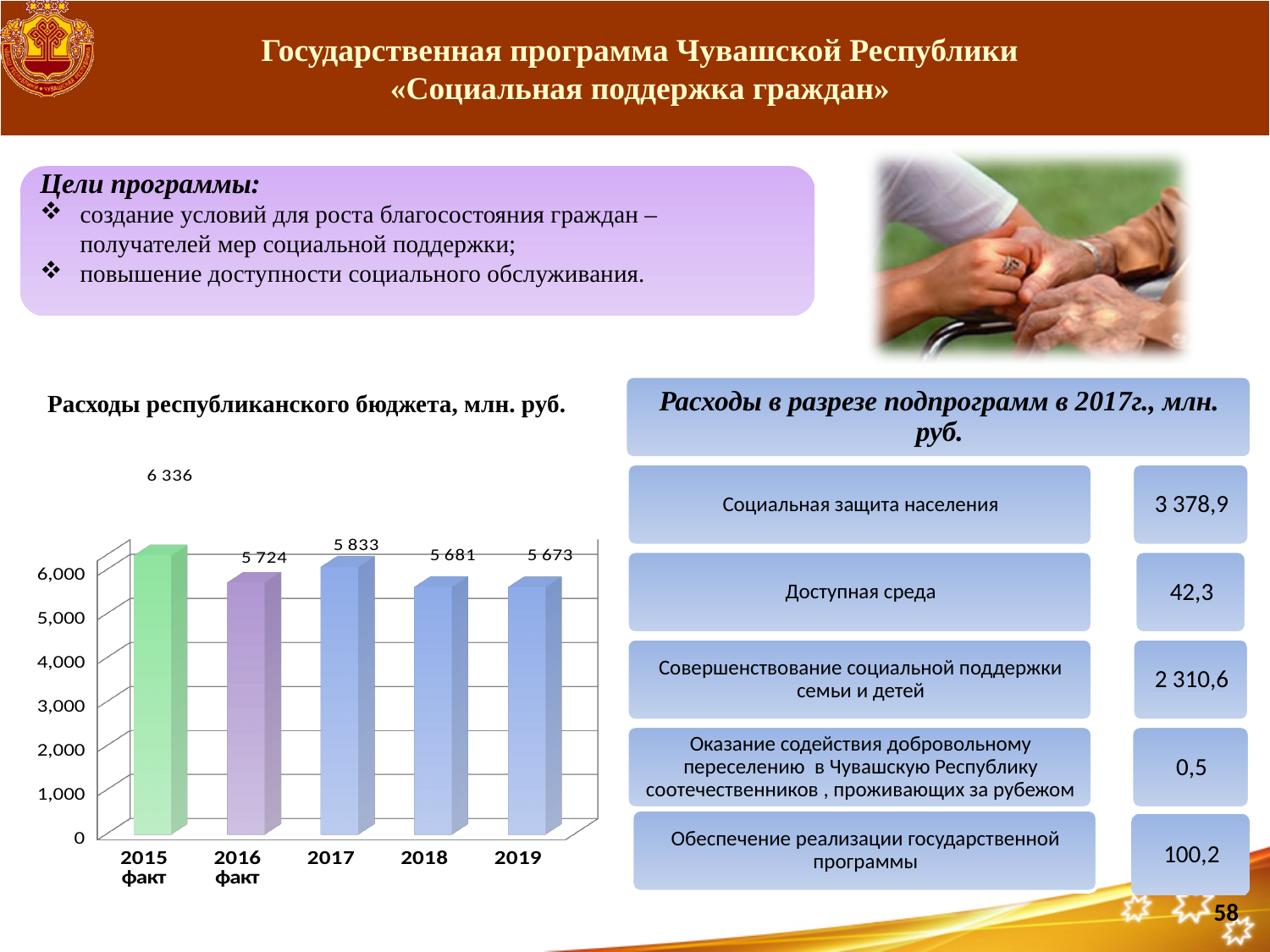
In the chart "Расходы республиканского бюджета, млн. руб.", is the value for 2018 greater or less than 6,000? less What is the difference between the values for 2015 факт and 2016 факт in the chart "Расходы республиканского бюджета, млн. руб."? 612 What is the value for 2015 факт in the chart "Расходы республиканского бюджета, млн. руб."? 6 336 In the chart "Расходы республиканского бюджета, млн. руб.", which is larger: the value for 2016 факт or the value for 2017? 2017 What is the difference between the values for 2017 and 2018 in the chart "Расходы республиканского бюджета, млн. руб."? 152 What kind of chart is "Расходы республиканского бюджета, млн. руб."? bar chart What is the value for 2017 in the chart "Расходы республиканского бюджета, млн. руб."? 5 833 Which year has the lowest value in the chart "Расходы республиканского бюджета, млн. руб."? 2019 In the chart "Расходы республиканского бюджета, млн. руб.", do the values rise or fall from 2017 to 2019? fall Which year has the highest value in the chart "Расходы республиканского бюджета, млн. руб."? 2015 факт How many years are shown on the x axis of the chart "Расходы республиканского бюджета, млн. руб."? 5 What is the value for 2019 in the chart "Расходы республиканского бюджета, млн. руб."? 5 673